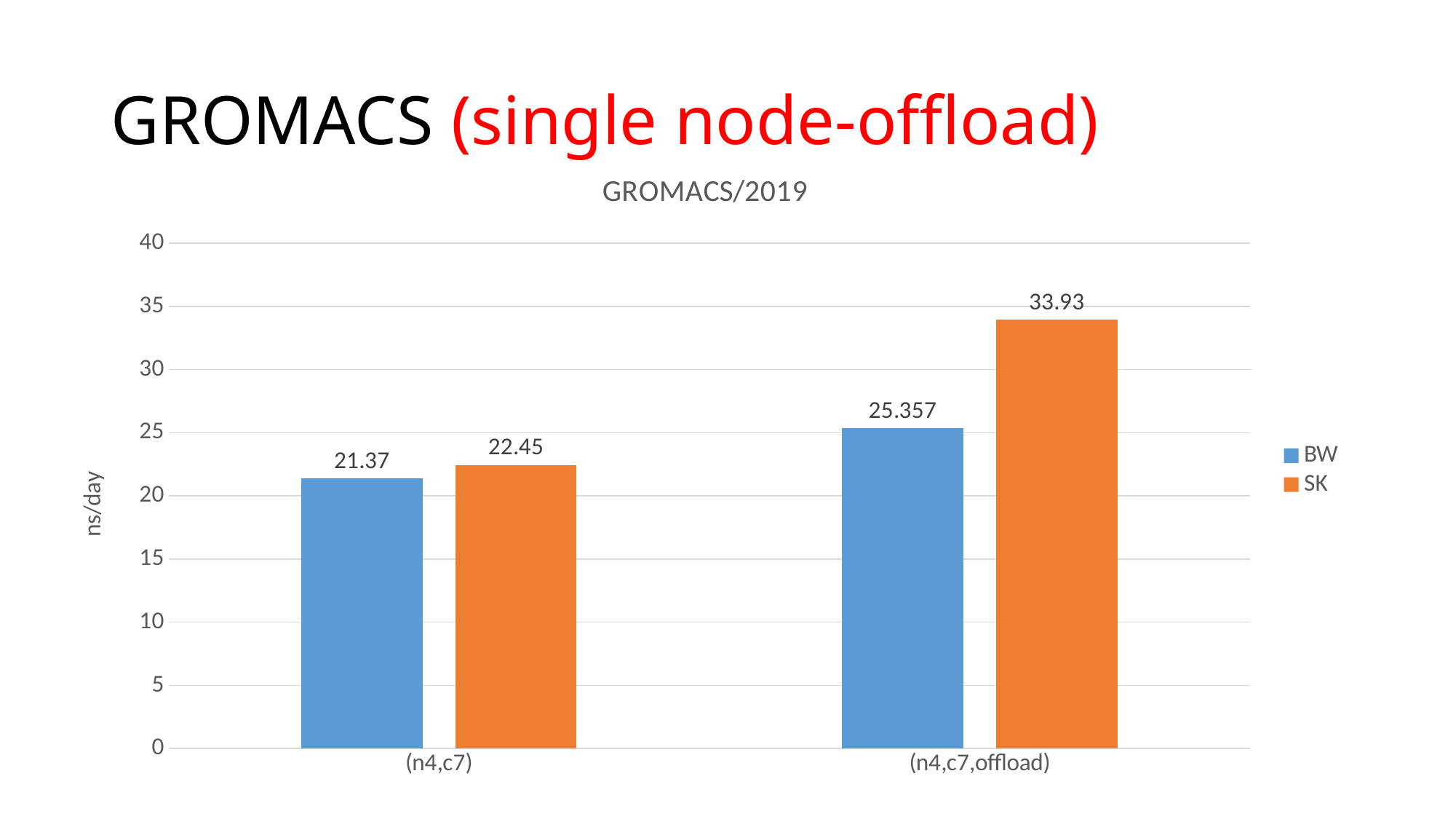
Is the SK value for (n4,c7,offload) greater or less than 30? greater Which is larger for (n4,c7,offload): BW or SK? SK How many series does the legend list? 2 Which bar has the lowest value in the chart? BW for (n4,c7) What is the SK value for (n4,c7,offload)? 33.93 How many categories are shown on the x axis? 2 What is the difference between the SK and BW values for (n4,c7,offload)? 8.573 Which series has the highest value in the chart? SK What is the BW value for (n4,c7,offload)? 25.357 What is the BW value for (n4,c7)? 21.37 What is the SK value for (n4,c7)? 22.45 What type of chart is shown? bar chart